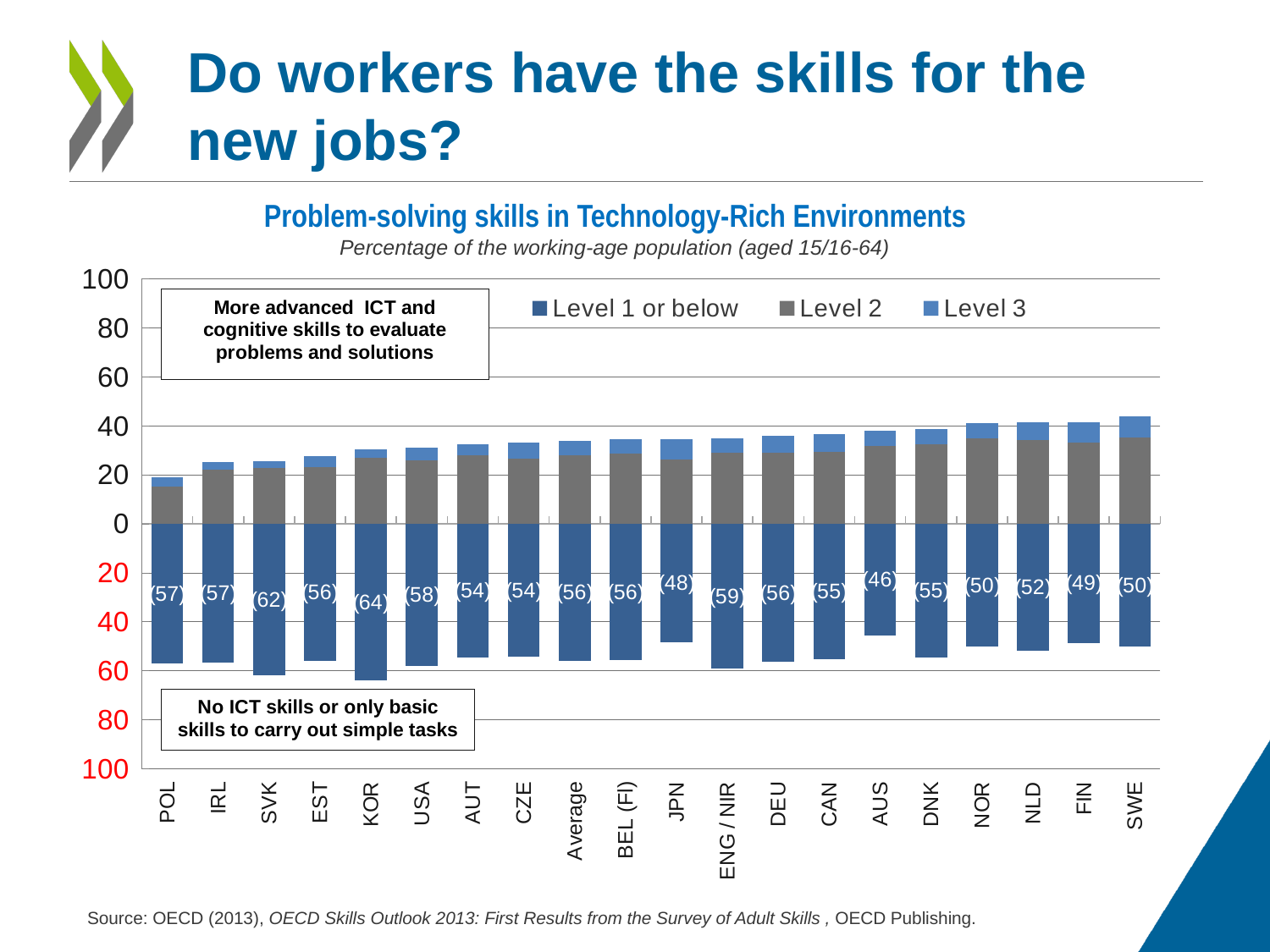
How many countries/categories are shown along the x axis? 20 What is the difference between the Level 1 or below values for SVK and JPN? 14 Which has a larger Level 1 or below value, ENG / NIR or FIN? ENG / NIR What is the labelled value for Level 1 or below for AUS? 46 What kind of chart is shown on the slide? bar chart What is the labelled value for Level 1 or below for KOR? 64 What is the labelled value for Level 1 or below for the Average category? 56 How many series does the legend list? 3 Which category has the lowest labelled Level 1 or below value? AUS Is the combined Level 2 and Level 3 value for SWE greater or less than 40? greater Which category has the highest labelled Level 1 or below value? KOR What is the title of the chart? Problem-solving skills in Technology-Rich Environments